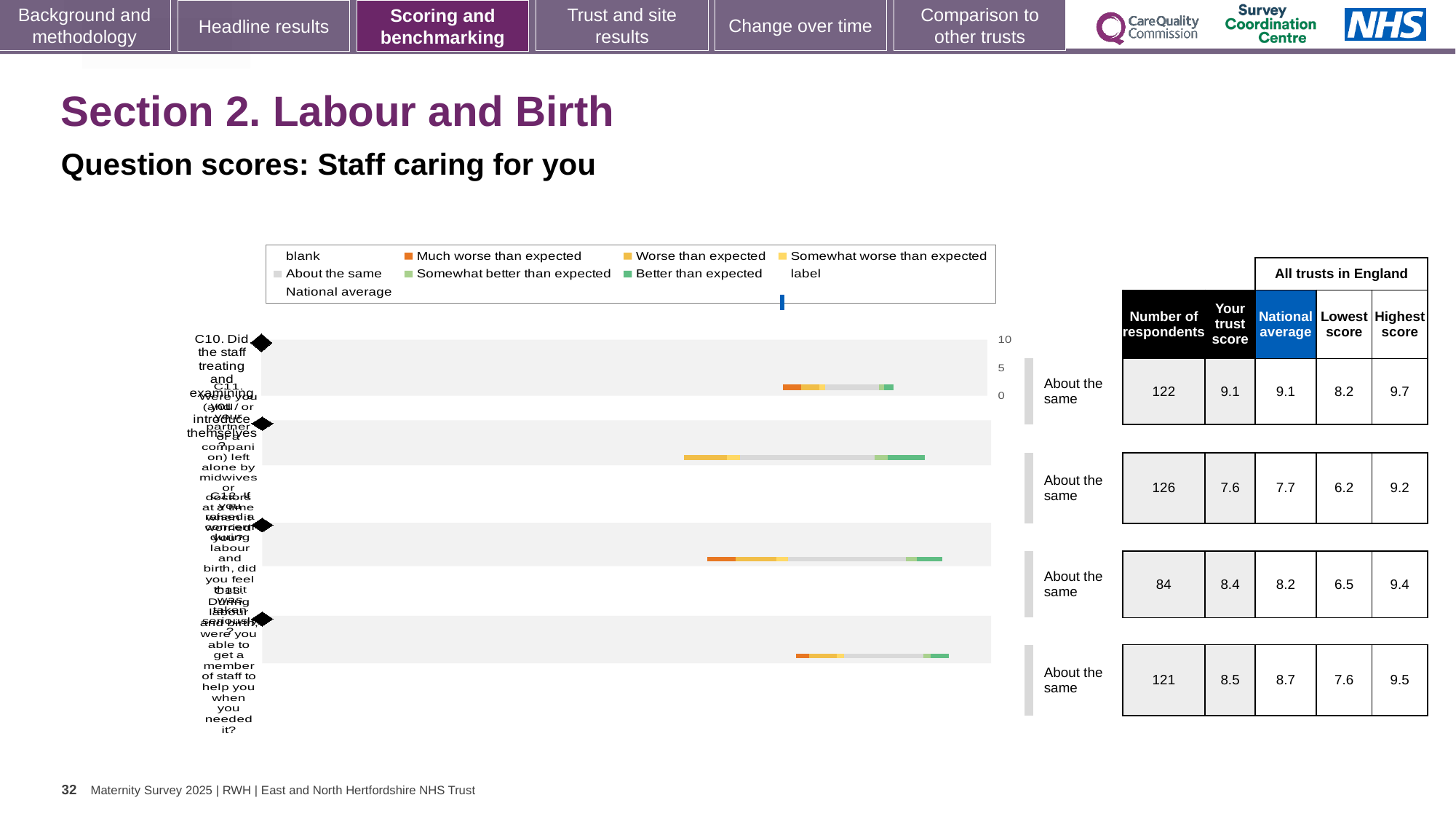
What comparison label is shown next to each of the four question rows? About the same In the table beside the chart, for the third question row, which is larger: your trust score or the national average? your trust score (8.4) In the table beside the chart, which question row has the lowest number of respondents? the third row (84) What colour represents 'Much worse than expected' in the chart legend? orange In the table beside the chart, what is the difference between the highest score and the lowest score for the first question row? 1.5 In the table beside the chart, what is the number of respondents for the first (top) question row? 122 In the table beside the chart, which question row has the highest number of respondents? the second row (126) What kind of chart is shown on the slide? bar chart In the table beside the chart, what is the national average for the fourth (bottom) question row? 8.7 In the table beside the chart, what is 'Your trust score' for the second question row? 7.6 What colour represents 'Better than expected' in the chart legend? green How many question rows (bars) are plotted in the chart? 4